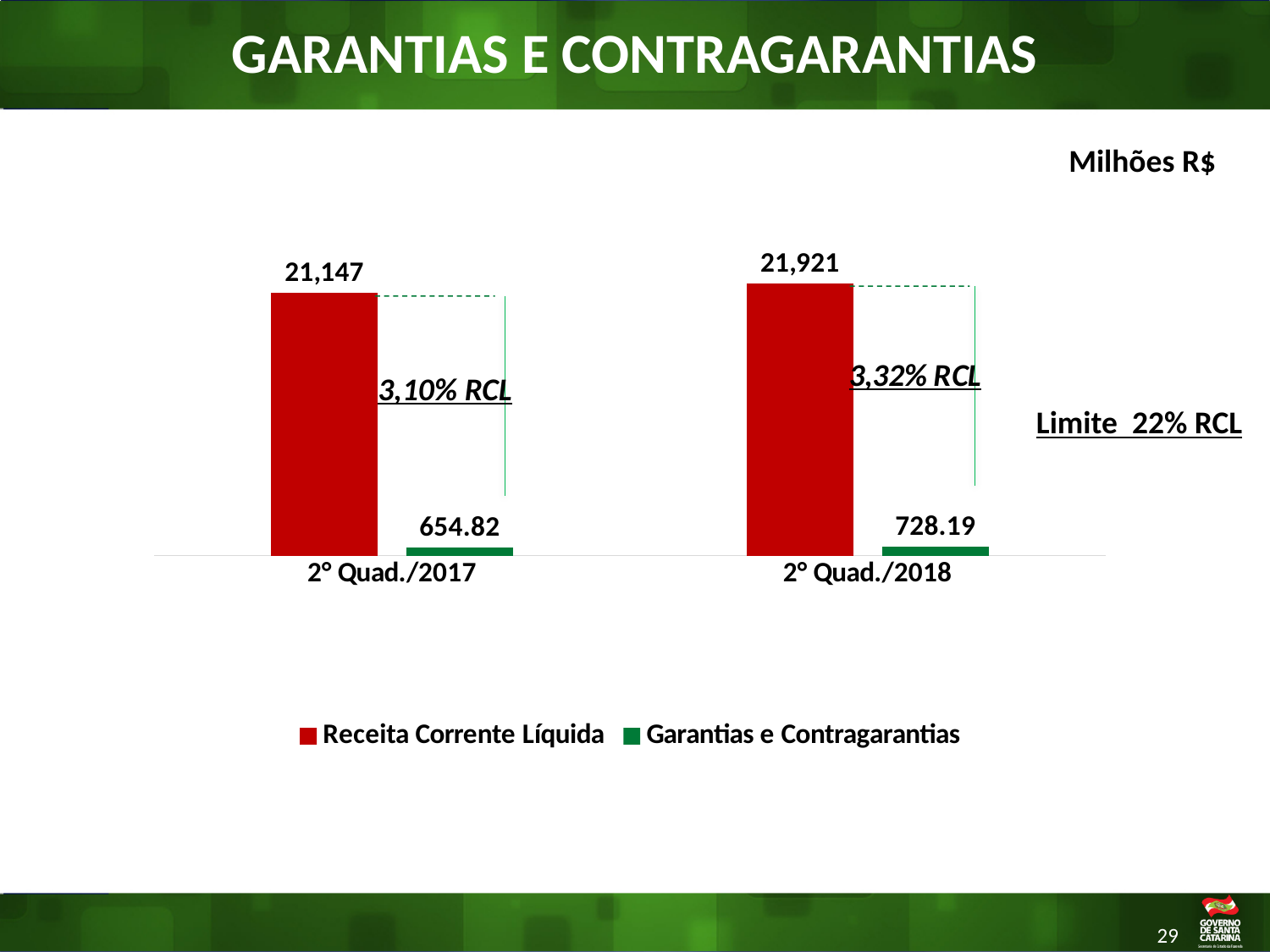
What is the value of Garantias e Contragarantias for 2° Quad./2017? 654.82 What is the value of Garantias e Contragarantias for 2° Quad./2018? 728.19 What percentage of RCL do Garantias e Contragarantias represent in 2° Quad./2018, according to the annotation? 3,32% RCL Which period has the lower value of Garantias e Contragarantias? 2° Quad./2017 What is the value of Receita Corrente Líquida for 2° Quad./2018? 21,921 Is Garantias e Contragarantias larger in 2° Quad./2017 or in 2° Quad./2018? 2° Quad./2018 What type of chart is shown on the slide? Bar chart Which period has the higher Receita Corrente Líquida? 2° Quad./2018 What is the difference in Garantias e Contragarantias between 2° Quad./2018 and 2° Quad./2017? 73.37 By how much did Receita Corrente Líquida increase from 2° Quad./2017 to 2° Quad./2018? 774 How many series does the legend list? 2 What is the value of Receita Corrente Líquida for 2° Quad./2017? 21,147